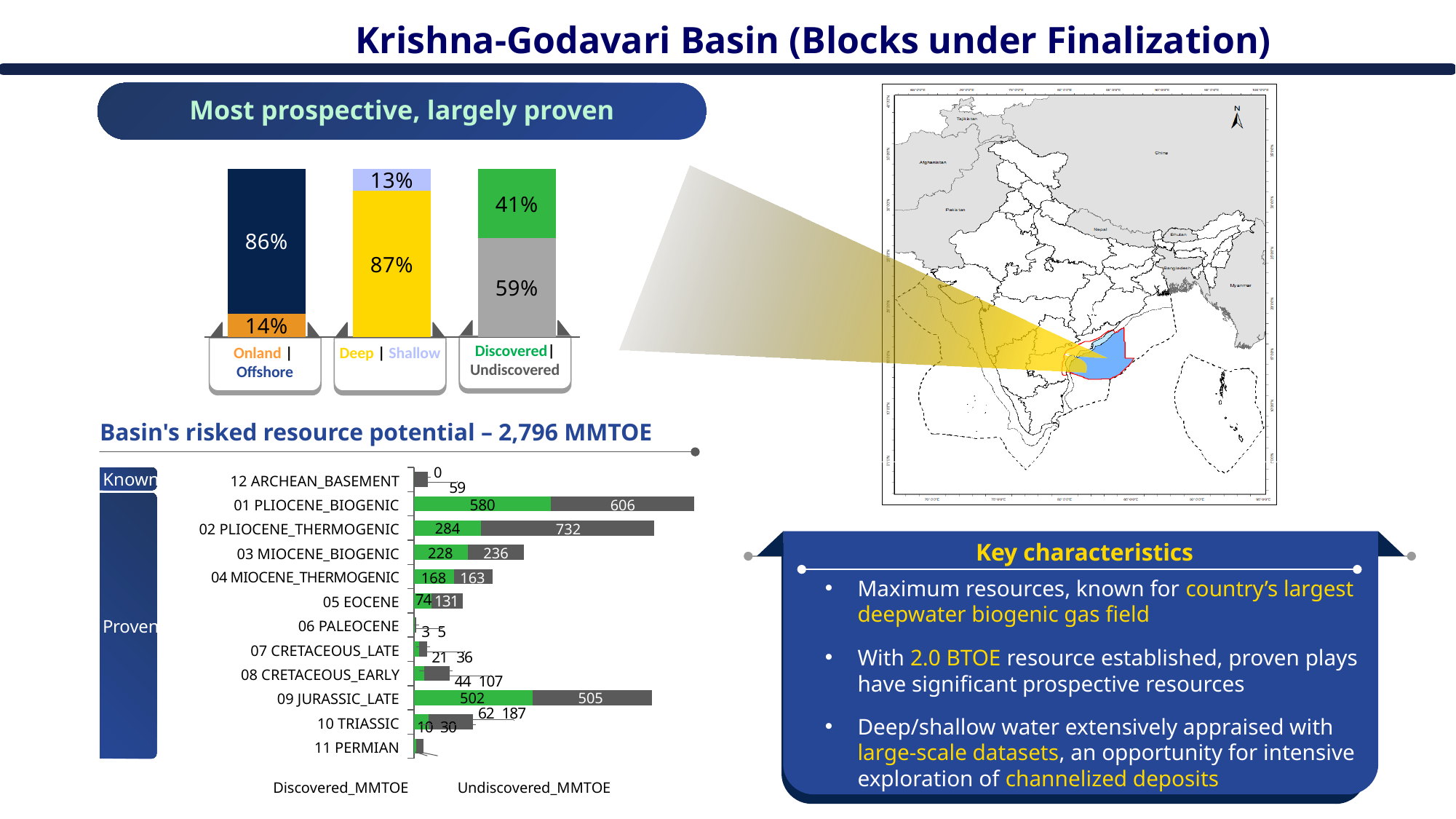
What type of chart is the 'Basin's risked resource potential' chart? Stacked bar chart In the top stacked bar chart, what is the difference between the Discovered and Undiscovered percentages? 18% In the 'Basin's risked resource potential' chart, which play has the highest Undiscovered_MMTOE value? 02 PLIOCENE_THERMOGENIC In the top stacked bar chart, what percentage is shown for Onland? 14% In the 'Basin's risked resource potential' chart, how many series does the legend list? 2 In the top stacked bar chart, which is larger, the Offshore share or the Onland share? Offshore In the 'Basin's risked resource potential' chart, what is the Discovered_MMTOE value for 01 PLIOCENE_BIOGENIC? 580 In the top stacked bar chart, what percentage is shown for Undiscovered? 59% In the 'Basin's risked resource potential' chart, what is the Undiscovered_MMTOE value for 02 PLIOCENE_THERMOGENIC? 732 In the 'Basin's risked resource potential' chart, what is the total of the stacked bar for 09 JURASSIC_LATE? 1007 In the 'Basin's risked resource potential' chart, what is the difference between the Discovered_MMTOE values of 03 MIOCENE_BIOGENIC and 04 MIOCENE_THERMOGENIC? 60 In the top stacked bar chart, what percentage is shown for Deep water? 87%